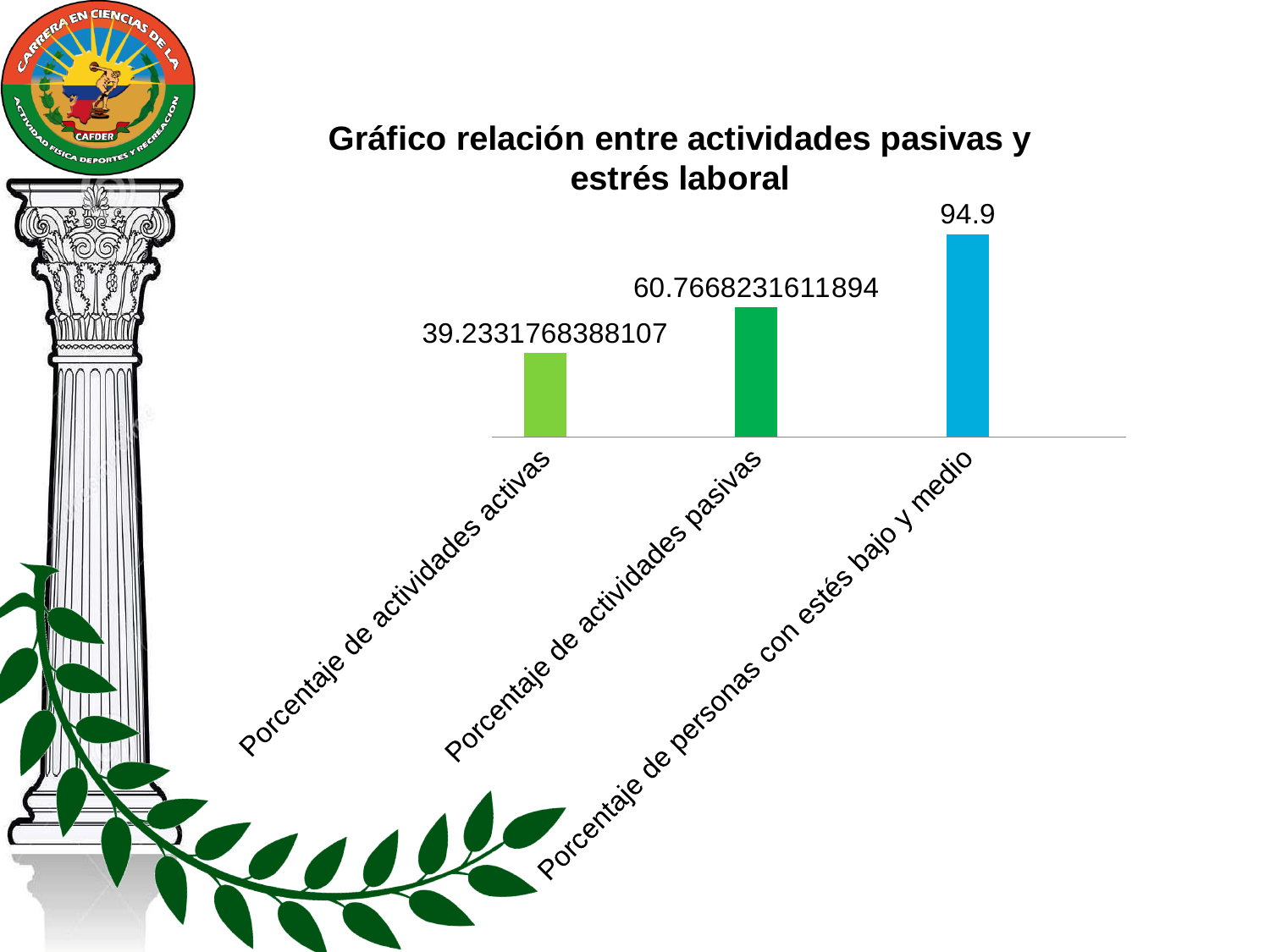
Which category has the lowest value? Porcentaje de actividades activas What is the difference between the values for "Porcentaje de personas con estés bajo y medio" and "Porcentaje de actividades pasivas"? 34.1331768388106 How many bars does the chart show? 3 What is the value for "Porcentaje de actividades activas"? 39.2331768388107 What is the value for "Porcentaje de actividades pasivas"? 60.7668231611894 Which category has the highest value? Porcentaje de personas con estés bajo y medio What is the title of the chart? Gráfico relación entre actividades pasivas y estrés laboral What kind of chart is shown on the slide? Bar chart Do the values rise or fall from left to right across the categories? Rise What is the value for "Porcentaje de personas con estés bajo y medio"? 94.9 Which is larger, the value for "Porcentaje de actividades activas" or the value for "Porcentaje de actividades pasivas"? Porcentaje de actividades pasivas What is the difference between the values for "Porcentaje de actividades pasivas" and "Porcentaje de actividades activas"? 21.5336463223787